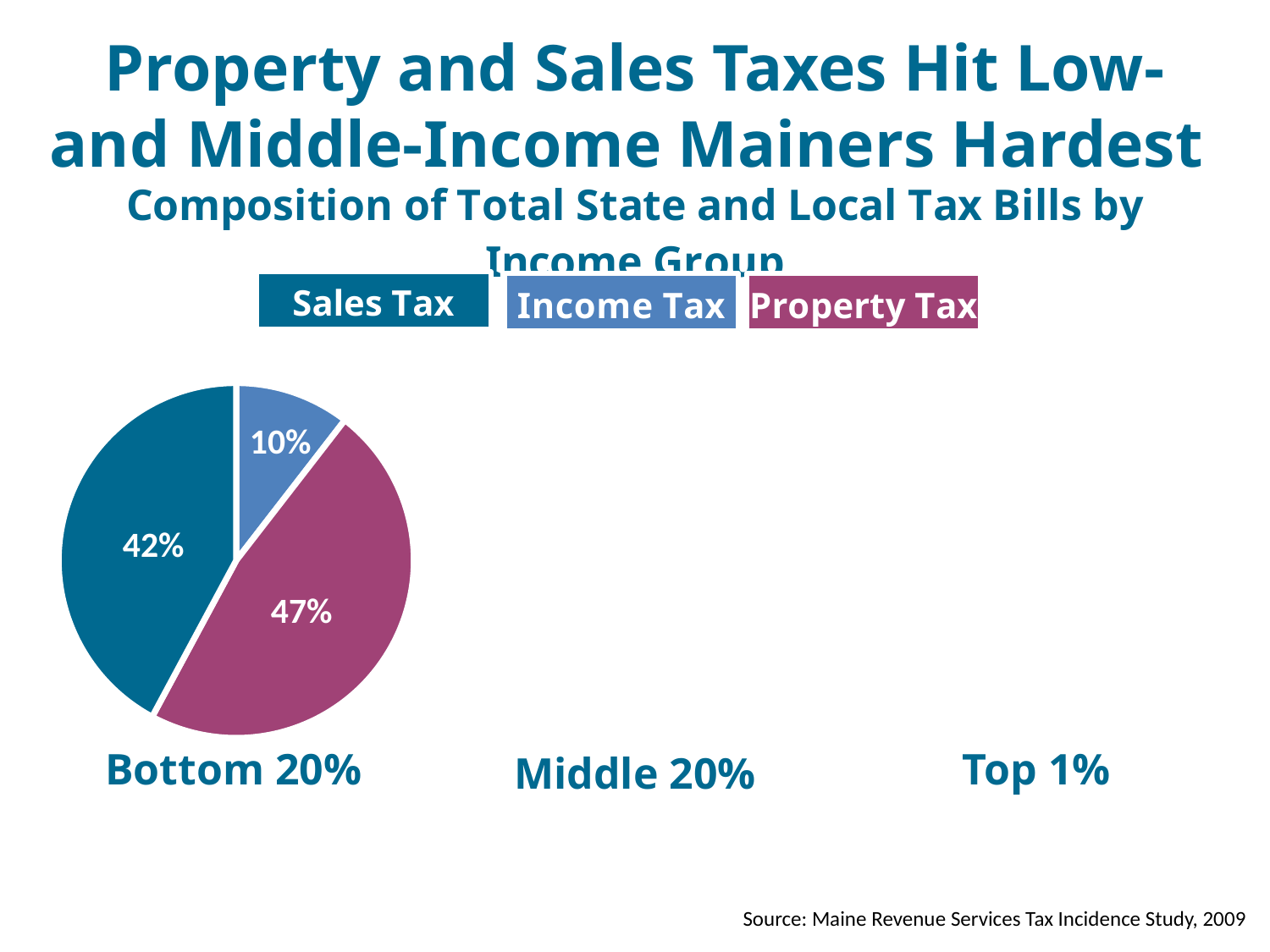
How many tax categories does the legend list? 3 How many slices does the Bottom 20% pie chart have? 3 In the Bottom 20% pie chart, how many percentage points larger is the Sales Tax share than the Income Tax share? 32 percentage points In the Bottom 20% pie chart, how many percentage points larger is the Property Tax share than the Sales Tax share? 5 percentage points What kind of chart is shown for the Bottom 20% income group? Pie chart In the Bottom 20% pie chart, which tax makes up the smallest share? Income Tax In the Bottom 20% pie chart, which tax makes up the largest share? Property Tax In the Bottom 20% pie chart, which is larger: the Sales Tax share or the Income Tax share? Sales Tax In the Bottom 20% pie chart, what share of the tax bill is Income Tax? 10% According to the legend, which tax category is shown in magenta? Property Tax In the Bottom 20% pie chart, what share of the tax bill is Sales Tax? 42% In the Bottom 20% pie chart, what share of the tax bill is Property Tax? 47%